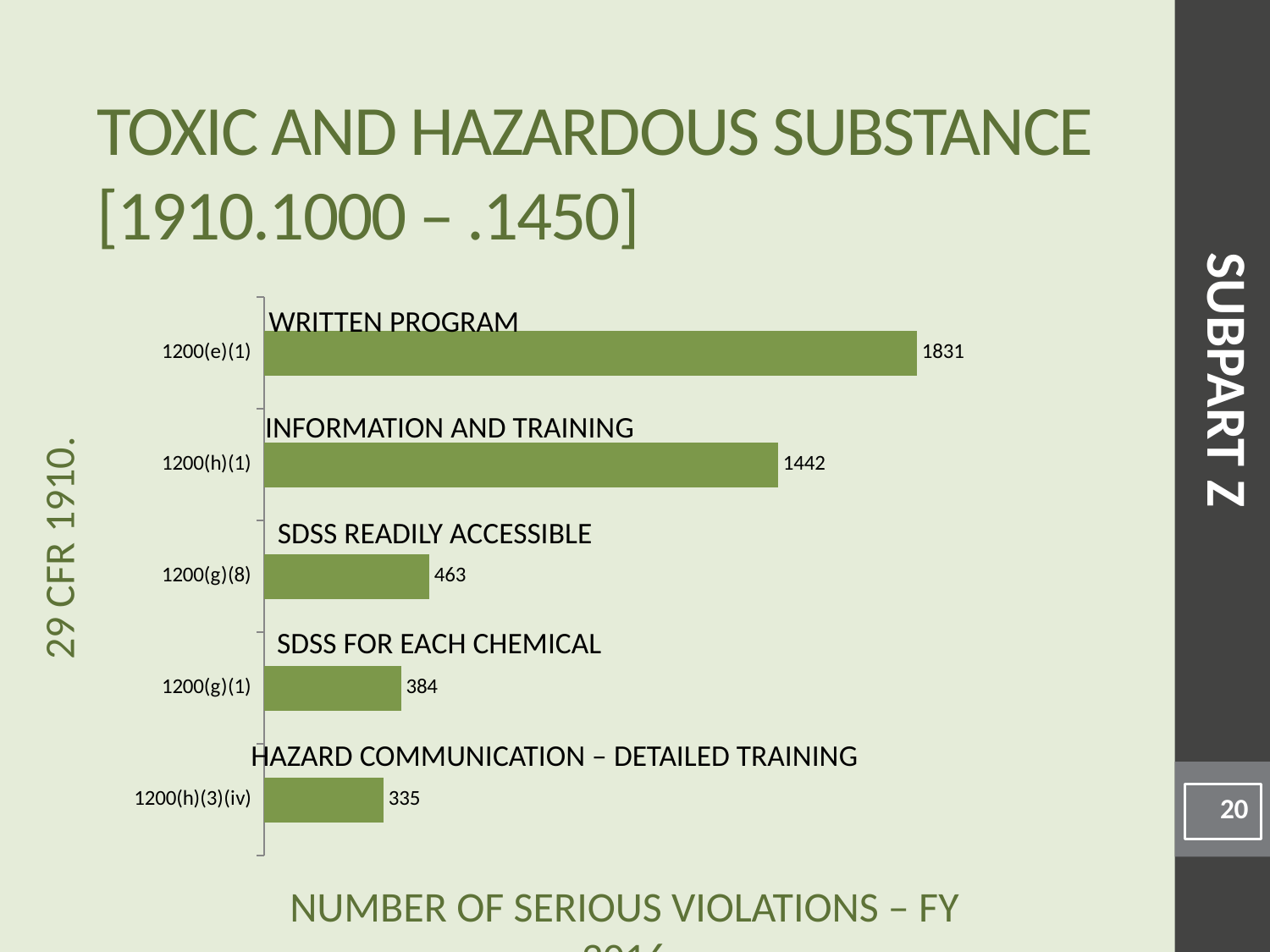
Which category has the lowest number of serious violations? 1200(h)(3)(iv) What is the number of serious violations for 1200(h)(3)(iv)? 335 Which has more serious violations, 1200(g)(1) or 1200(h)(3)(iv)? 1200(g)(1) What is the number of serious violations for 1200(h)(1)? 1442 What kind of chart is shown on the slide? Bar chart Which category has the highest number of serious violations? 1200(e)(1) What is the number of serious violations for 1200(g)(8)? 463 What is the difference between the values for 1200(g)(8) and 1200(g)(1)? 79 What is the difference between the values for 1200(e)(1) and 1200(h)(1)? 389 How many categories are shown in the chart? 5 What label is shown above the bar for 1200(g)(8)? SDSS READILY ACCESSIBLE What is the number of serious violations for 1200(e)(1)? 1831